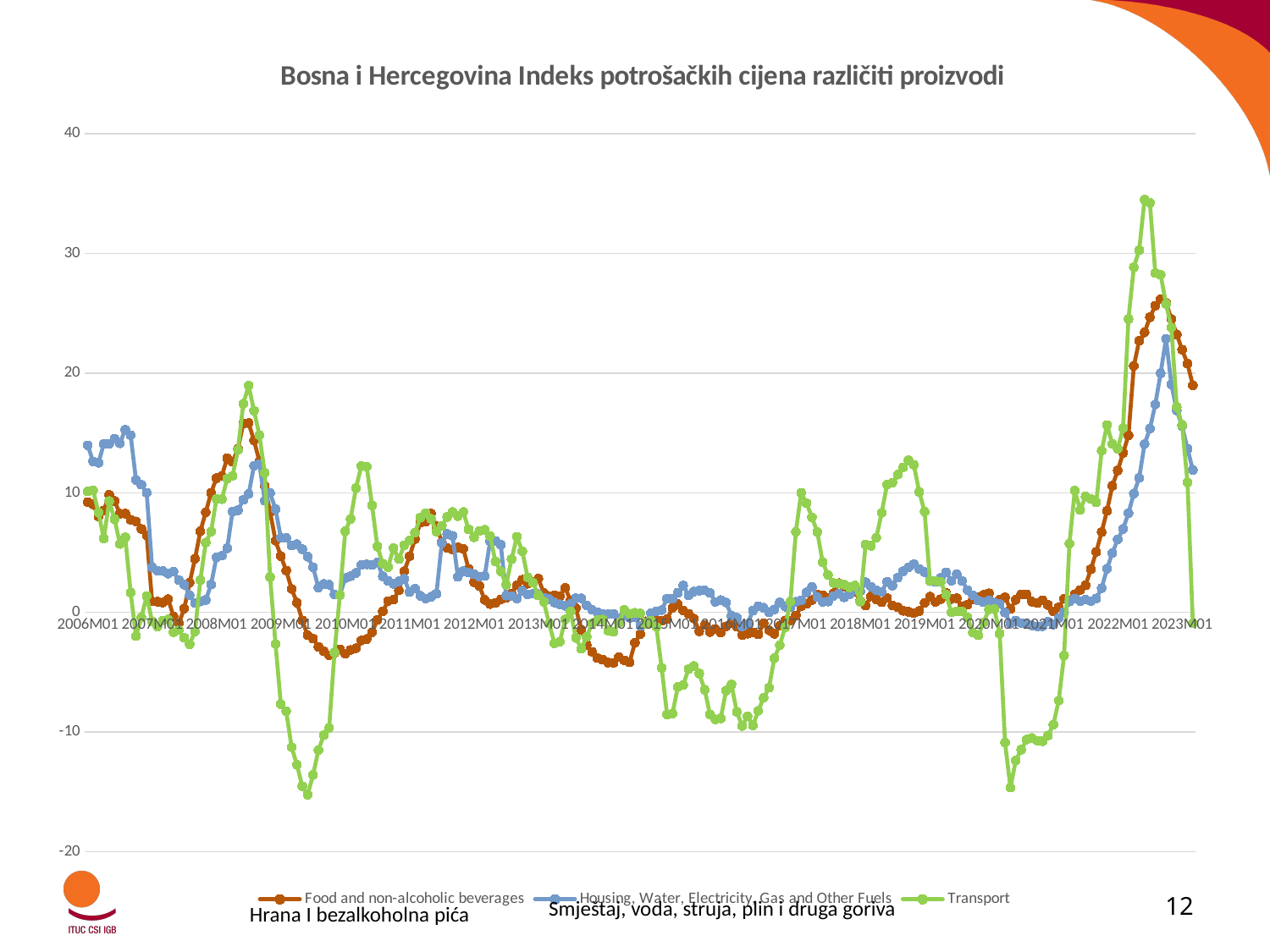
Which series reaches the highest value anywhere on the chart? Transport Which series is drawn in green? Transport Which series reaches the lowest value anywhere on the chart? Transport What kind of chart is shown on the slide? line chart Is the peak value of the Food and non-alcoholic beverages series in 2022 greater or less than 20? greater Is the value of the Housing, Water, Electricity, Gas and Other Fuels series at 2006M01 greater or less than 10? greater How many series does the legend list? 3 What is the title of the chart? Bosna i Hercegovina Indeks potrošačkih cijena različiti proizvodi Is the peak value of the Transport series in 2022 greater or less than 30? greater At their 2022 peaks, which series is higher: Transport or Food and non-alcoholic beverages? Transport Does the Transport series rise or fall between 2021M01 and 2022M01? rise